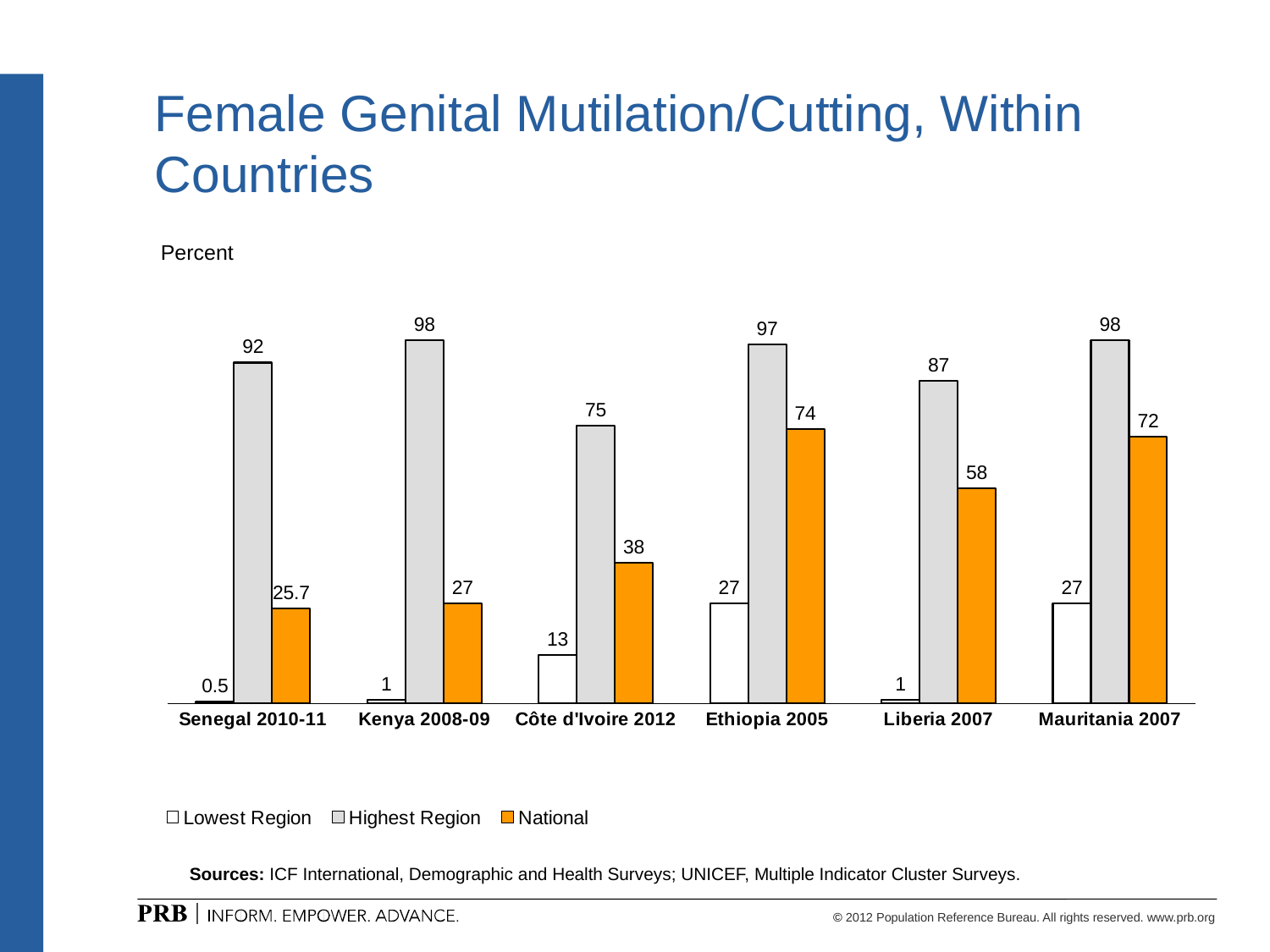
Which is larger, the National value for Liberia 2007 or the National value for Côte d'Ivoire 2012? Liberia 2007 What kind of chart is shown on the slide? Bar chart Which country has the highest Lowest Region value? Ethiopia 2005 and Mauritania 2007 (both 27) How many series does the legend list? 3 Which country has the lowest National value? Senegal 2010-11 How many countries are shown on the x axis? 6 What is the difference between the Highest Region and National values for Kenya 2008-09? 71 Which series is shown in orange in the legend? National What is the difference between the Highest Region and Lowest Region values for Mauritania 2007? 71 What is the Highest Region value for Liberia 2007? 87 What is the National value for Ethiopia 2005? 74 What is the Lowest Region value for Senegal 2010-11? 0.5